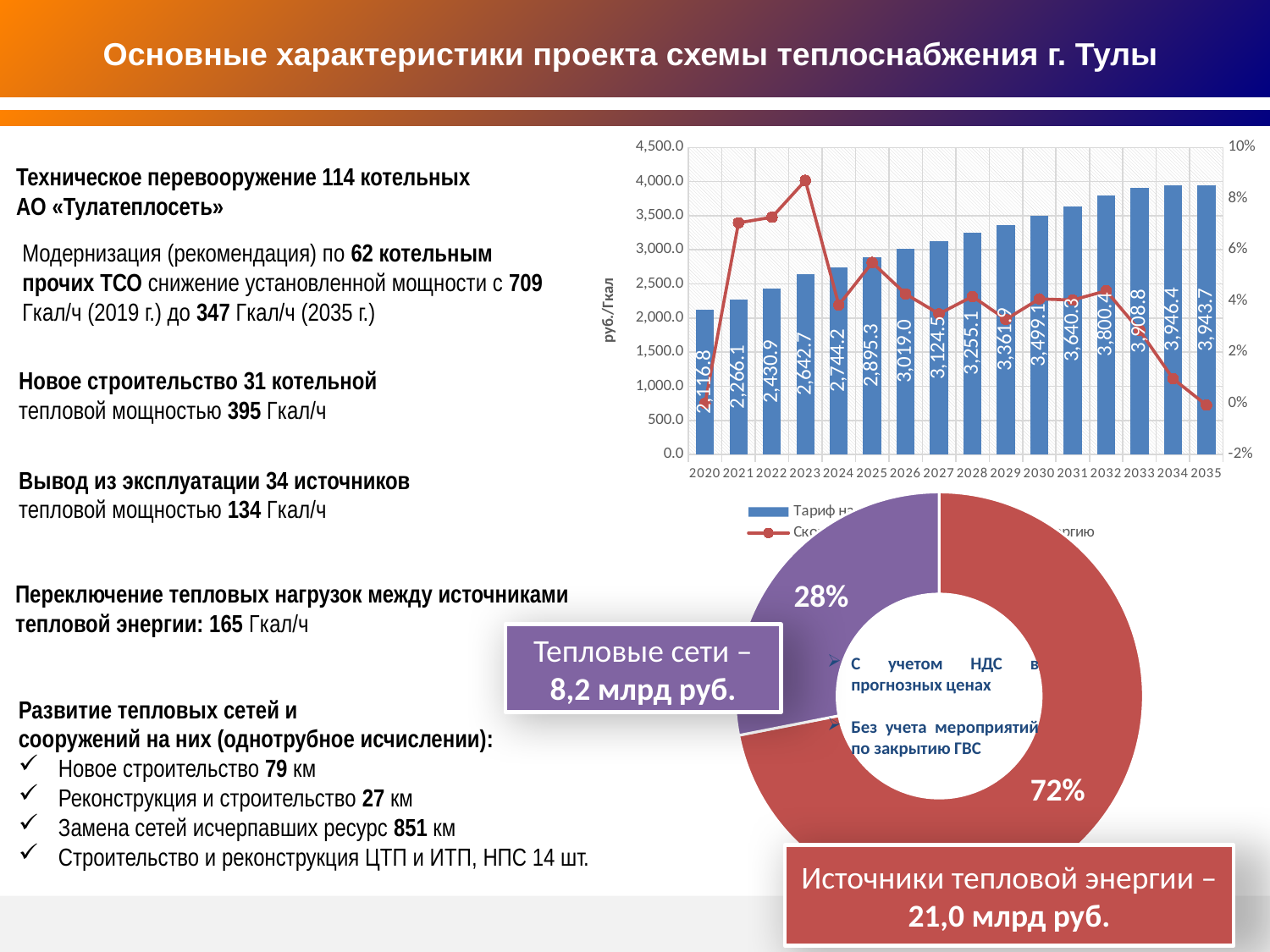
In the top-right bar chart, what is the bar value for 2035? 3,943.7 In the top-right chart, is the line value for 2023 greater or less than 8%? greater In the top-right bar chart, which year has the highest bar value? 2034 In the top-right bar chart, what is the bar value for 2030? 3,499.1 In the top-right bar chart, which year has the larger bar value, 2025 or 2026? 2026 What kind of chart is the top-right chart showing tariff values by year? bar chart with a line In the top-right bar chart, what is the bar value for 2020? 2,116.8 In the top-right bar chart, which year has the lowest bar value? 2020 In the top-right bar chart, what is the difference between the bar values for 2035 and 2020? 1,826.9 In the bottom-right doughnut chart, what share is shown for the purple slice (Тепловые сети)? 28% In the top-right bar chart, do the bar values generally rise or fall from 2020 to 2035? rise How many years are shown on the x axis of the top-right bar chart? 16